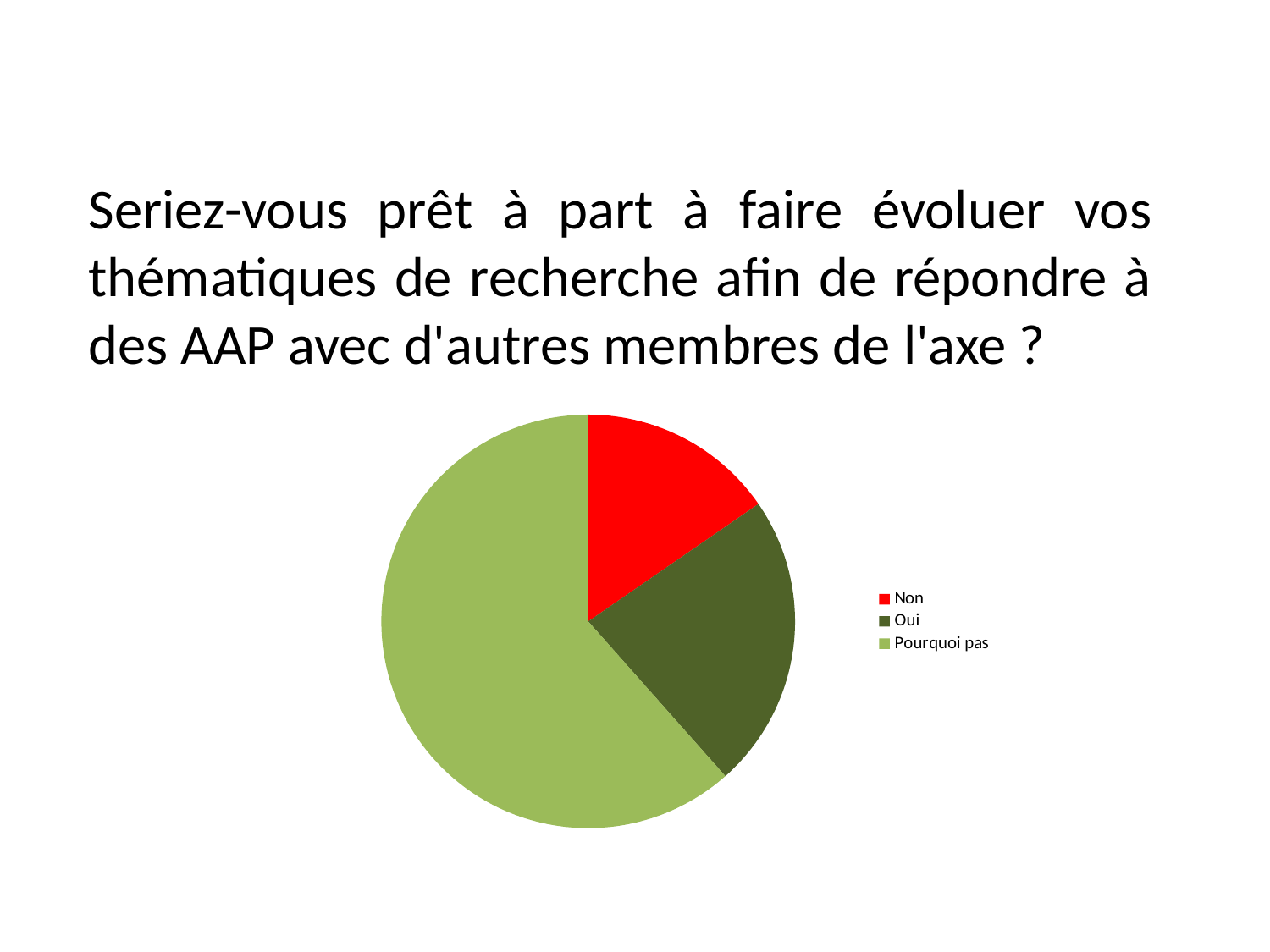
Does the Pourquoi pas slice take up more or less than half of the pie? more Which slice is larger, Oui or Non? Oui How many entries does the legend of the pie chart list? 3 Which legend entry is shown in light green? Pourquoi pas Which category has the smallest slice of the pie chart? Non What kind of chart is shown on the slide? pie chart How many slices does the pie chart have? 3 Which slice is larger, Pourquoi pas or Oui? Pourquoi pas What colour is the Non slice in the pie chart? red Which category has the largest slice of the pie chart? Pourquoi pas